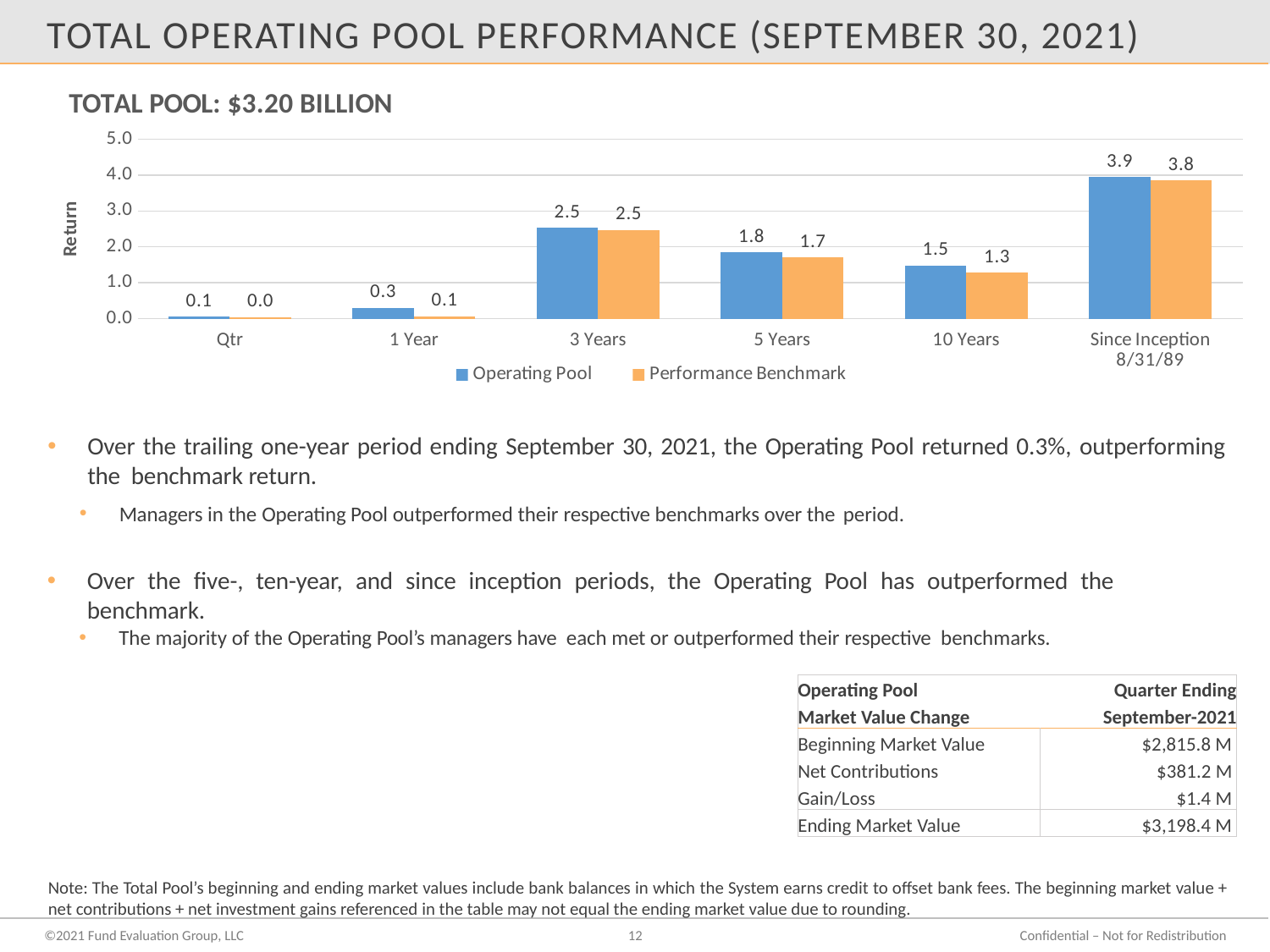
For the 5 Years period, which is larger: the Operating Pool return or the Performance Benchmark return? Operating Pool Which period has the lowest Performance Benchmark return? Qtr What is the Operating Pool return for the Qtr period? 0.1 How many periods are shown on the x axis of the chart? 6 What is the Operating Pool return for the 3 Years period? 2.5 What is the difference between the Operating Pool and Performance Benchmark returns for the 1 Year period? 0.2 What is the title shown above the chart? TOTAL POOL: $3.20 BILLION Which period has the highest Operating Pool return? Since Inception 8/31/89 How many series does the chart legend list? 2 What kind of chart is shown on the slide? Bar chart What is the label of the y axis of the chart? Return What is the Performance Benchmark return for the 10 Years period? 1.3